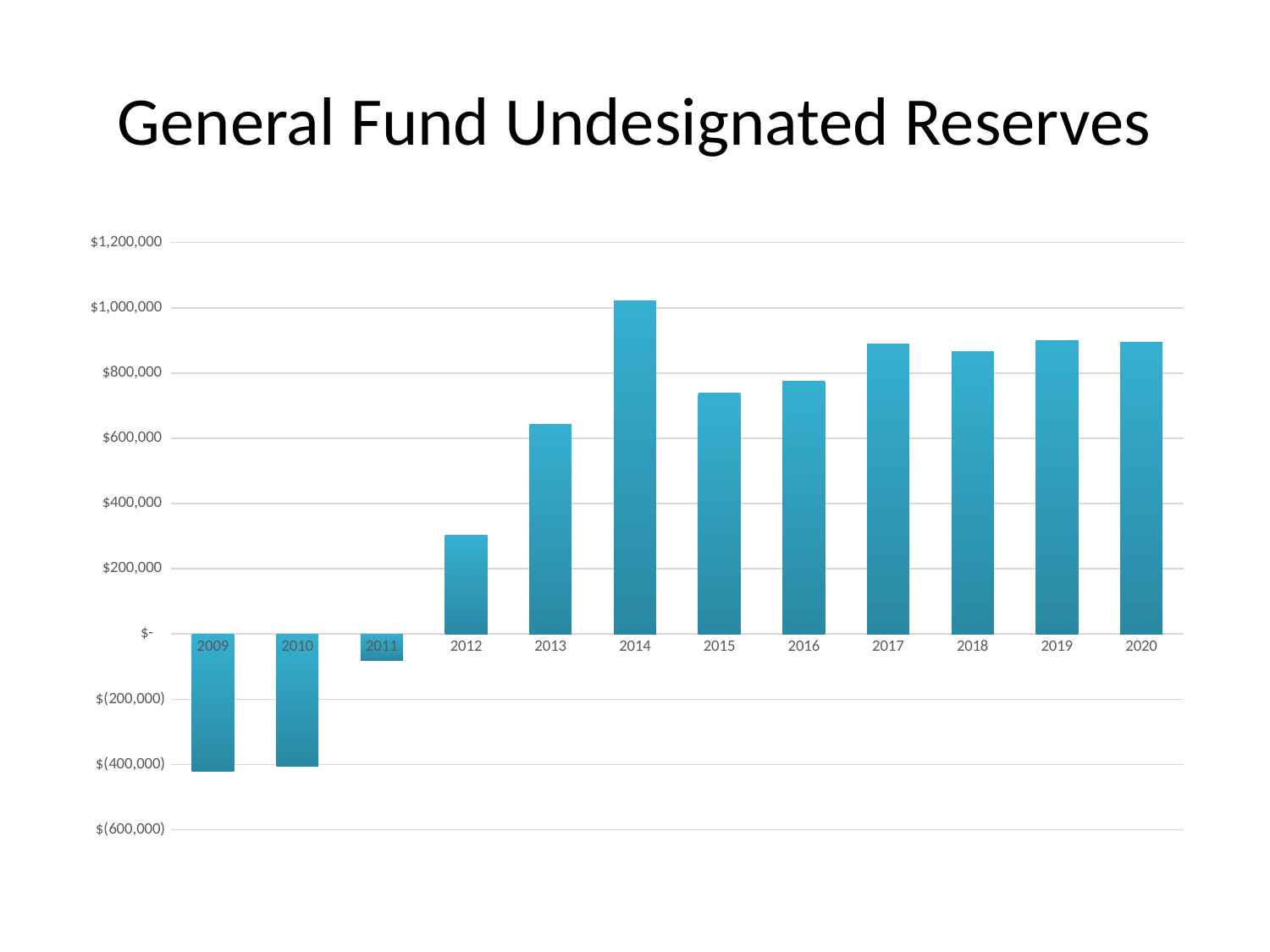
How many years are shown on the x axis of the chart? 12 Is the value for 2014 greater or less than $800,000? greater Which is larger, the value for 2011 or the value for 2012? 2012 Is the value for 2013 greater or less than $600,000? greater Do the values rise or fall from 2011 to 2014? Rise What is the title of the chart? General Fund Undesignated Reserves What type of chart is shown on the slide? Bar chart Which year has the highest General Fund Undesignated Reserves? 2014 Is the value for 2009 greater or less than $(200,000)? less Which is larger, the value for 2013 or the value for 2015? 2015